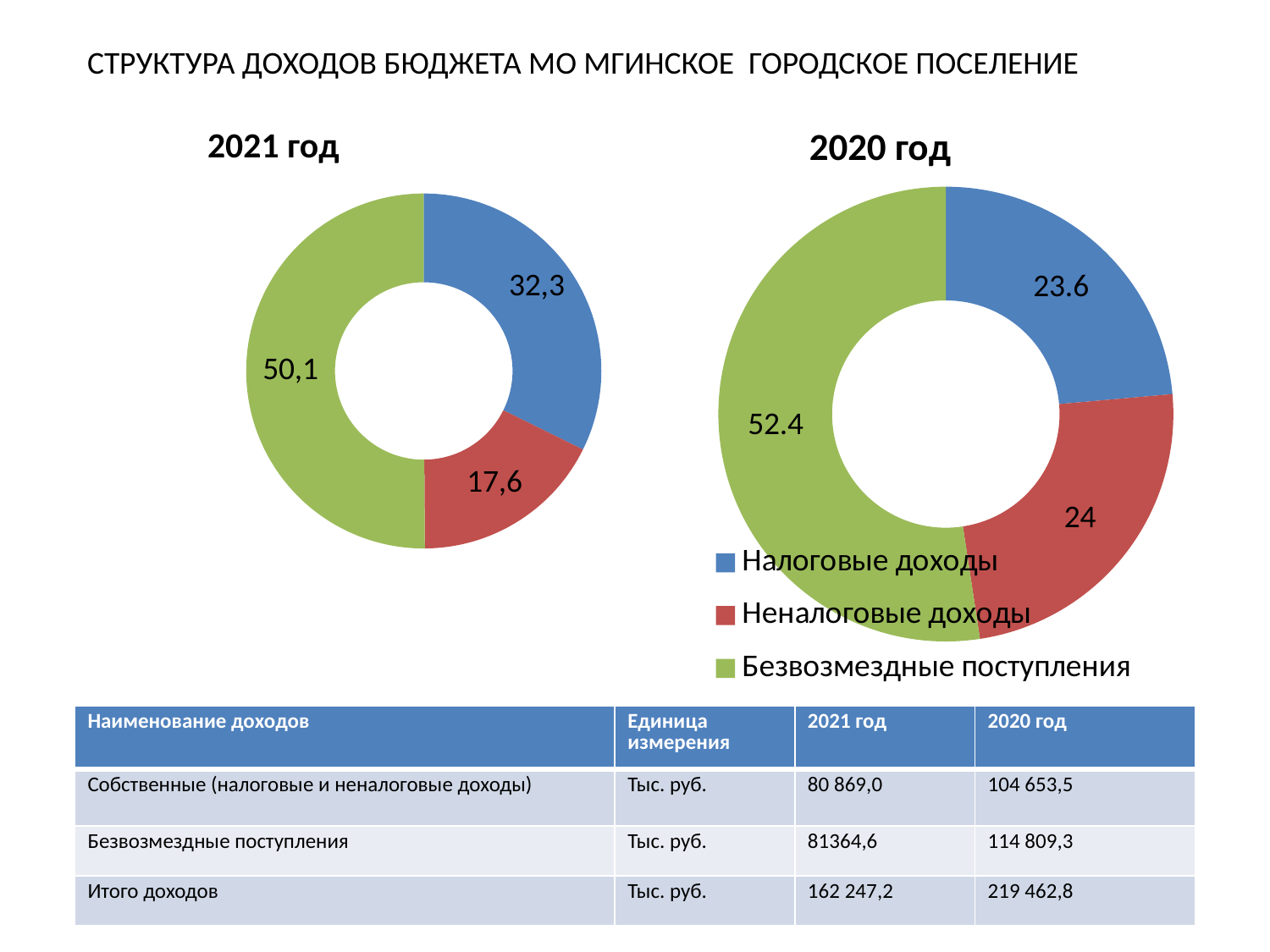
In the "2020 год" chart, what is the value for Неналоговые доходы? 24 In the "2021 год" chart, which category has the smallest share? Неналоговые доходы How many categories does the "2020 год" chart show? 3 In the "2020 год" chart, which category has the largest share? Безвозмездные поступления In the "2021 год" chart, what is the value for Неналоговые доходы? 17,6 Which is larger: Налоговые доходы in the "2021 год" chart or Налоговые доходы in the "2020 год" chart? 2021 год In the "2020 год" chart, what is the value for Безвозмездные поступления? 52.4 Which colour represents Безвозмездные поступления in the legend? Green In the "2021 год" chart, what is the difference between the values for Налоговые доходы and Неналоговые доходы? 14,7 In the "2021 год" chart, which category has the largest share? Безвозмездные поступления What kind of chart is the "2021 год" chart? Doughnut chart In the "2021 год" chart, what is the value for Налоговые доходы? 32,3